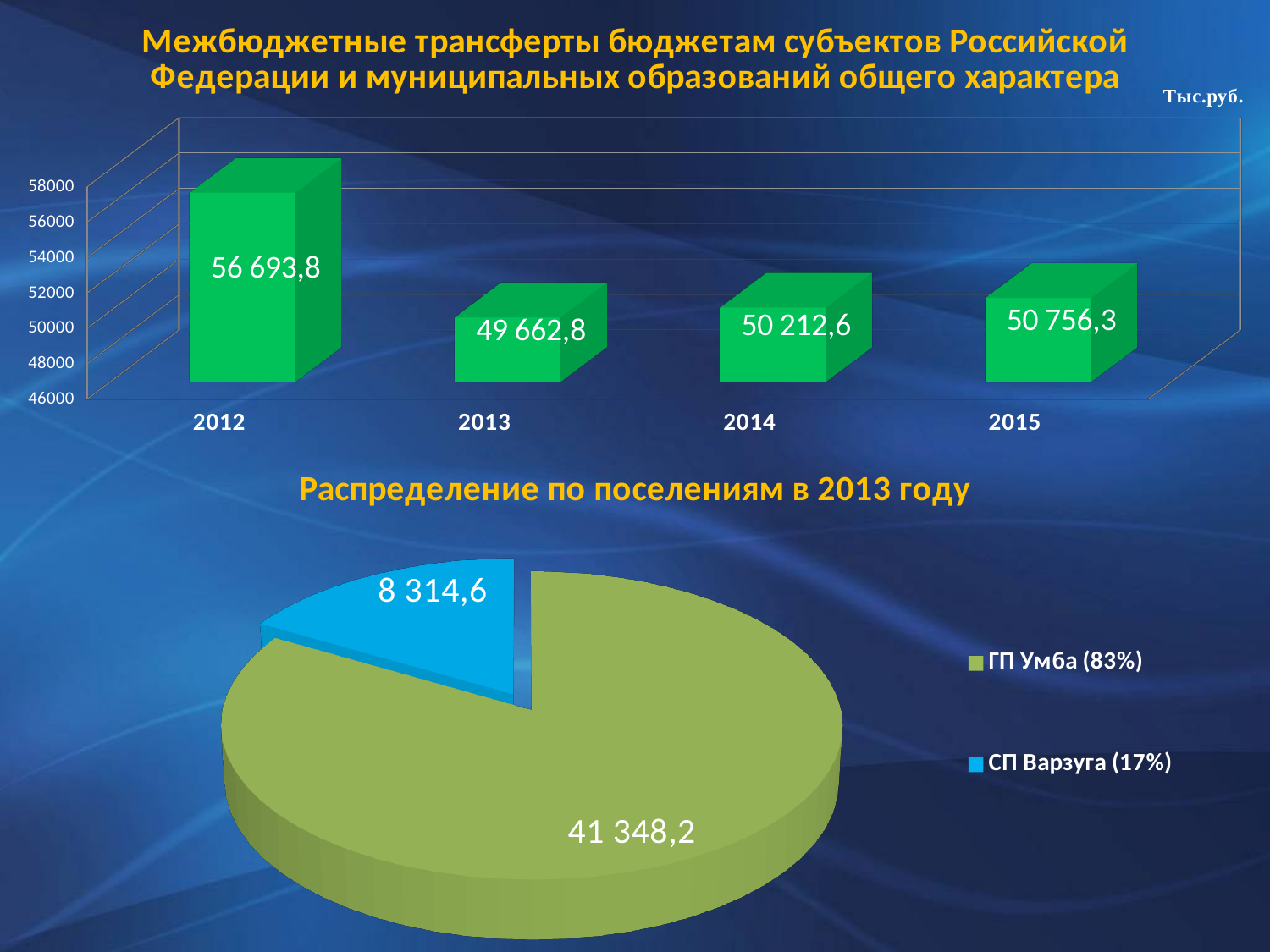
In the top bar chart, what is the value for 2014? 50 212,6 What unit is indicated for the top bar chart? Тыс.руб. In the pie chart 'Распределение по поселениям в 2013 году', what is the value for СП Варзуга? 8 314,6 How many years are shown in the top bar chart? 4 In the top bar chart, what is the value for 2012? 56 693,8 In the top bar chart, what is the difference between the values for 2012 and 2013? 7 031,0 In the top bar chart, which is larger: the value for 2015 or the value for 2014? 2015 In the top bar chart, which year has the highest value? 2012 In the top bar chart, is the value for 2013 greater or less than 50000? less In the top bar chart, which year has the lowest value? 2013 In the pie chart 'Распределение по поселениям в 2013 году', what share does ГП Умба have? 83% What kind of chart is the top chart on the slide? bar chart